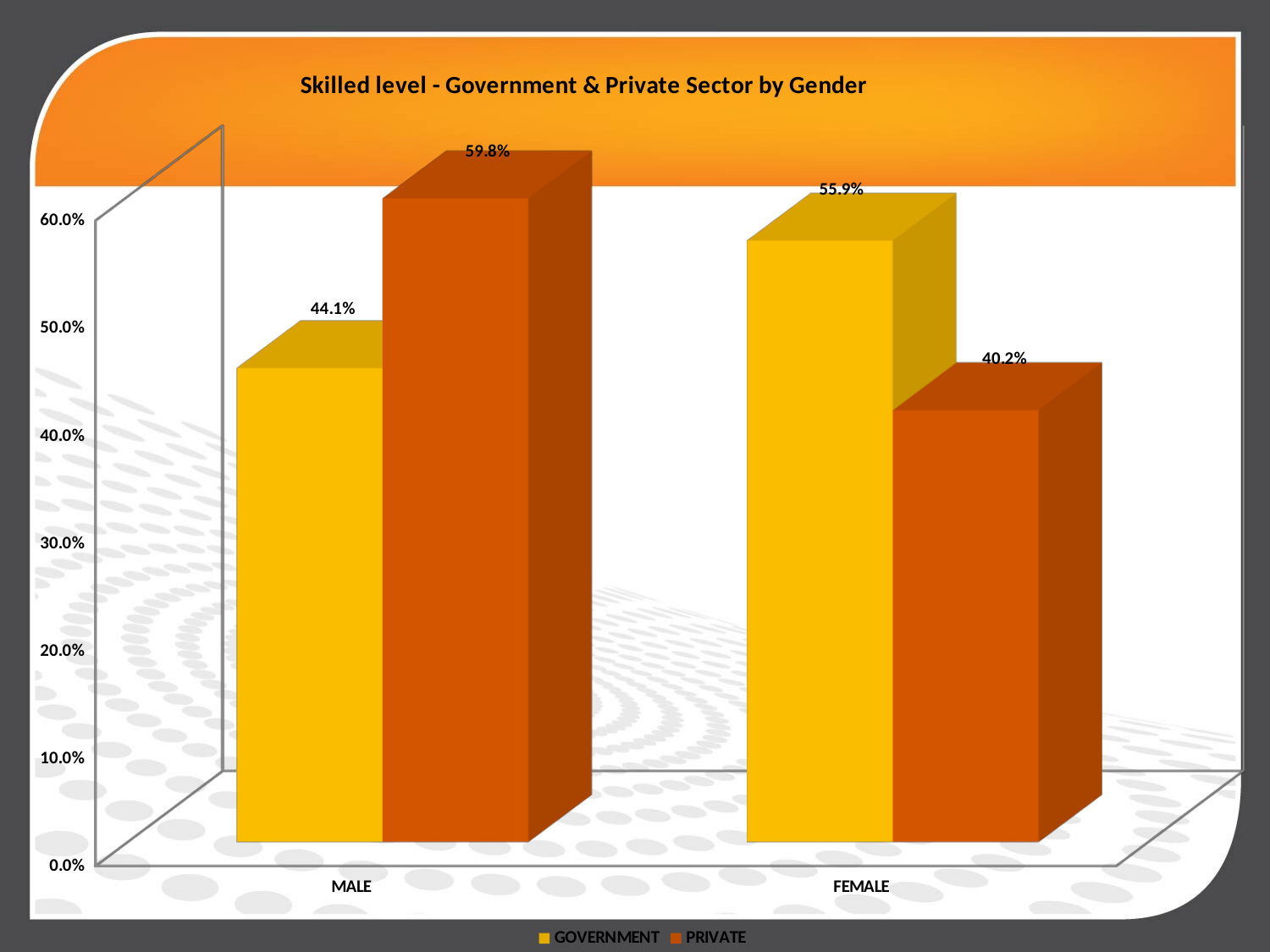
What is the Private value for Male? 59.8% What kind of chart is shown? Bar chart What is the difference between the Private and Government values for Male? 15.7% What is the Private value for Female? 40.2% How many series does the legend list? 2 Which gender has the lower Government value? Male Which is larger for Female: Government or Private? Government Which gender has the higher Private value? Male What is the difference between the Government and Private values for Female? 15.7% What is the title of the chart? Skilled level - Government & Private Sector by Gender What is the Government value for Female? 55.9% What is the Government value for Male? 44.1%